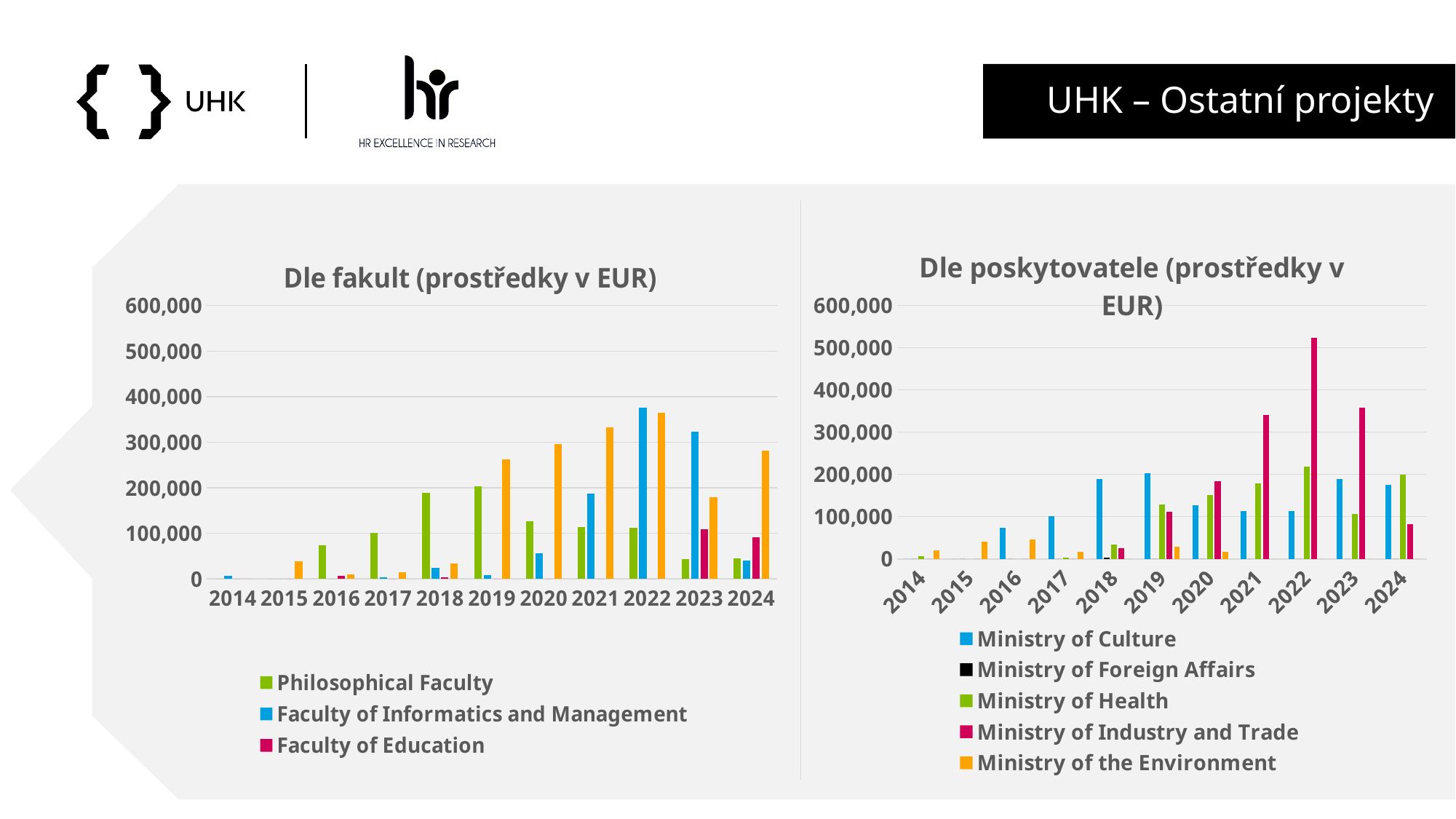
In the 'Dle poskytovatele (prostředky v EUR)' chart, in which year is the Ministry of Industry and Trade bar highest? 2022 In the 'Dle poskytovatele (prostředky v EUR)' chart, do the Ministry of Industry and Trade values rise or fall from 2019 to 2022? rise How many series does the legend of the 'Dle poskytovatele (prostředky v EUR)' chart list? 5 What kind of chart is the 'Dle fakult (prostředky v EUR)' chart on the left? bar chart In the 'Dle fakult (prostředky v EUR)' chart, is the value for Faculty of Informatics and Management in 2022 greater or less than 300,000? greater How many series does the legend of the 'Dle fakult (prostředky v EUR)' chart list? 3 In the 'Dle fakult (prostředky v EUR)' chart, is the value for Philosophical Faculty in 2018 greater or less than 200,000? less In the 'Dle fakult (prostředky v EUR)' chart, in which year is the Faculty of Informatics and Management bar highest? 2022 How many years are shown on the x axis of the 'Dle poskytovatele (prostředky v EUR)' chart? 11 In the 'Dle fakult (prostředky v EUR)' chart, which is larger in 2022: Faculty of Informatics and Management or Philosophical Faculty? Faculty of Informatics and Management In the 'Dle poskytovatele (prostředky v EUR)' chart, which is larger in 2021: Ministry of Industry and Trade or Ministry of Health? Ministry of Industry and Trade In the 'Dle poskytovatele (prostředky v EUR)' chart, is the value for Ministry of Industry and Trade in 2022 greater or less than 500,000? greater